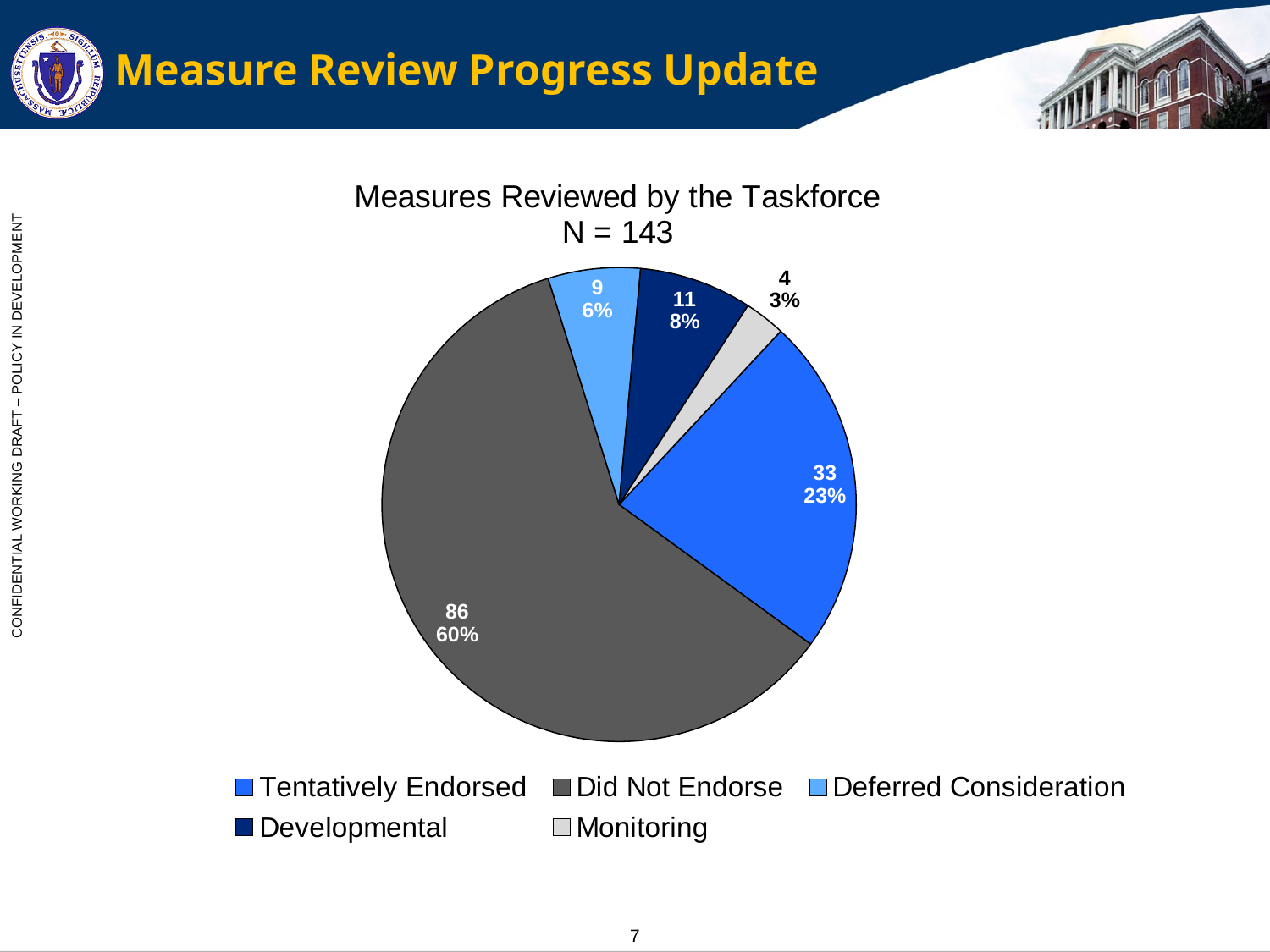
How many more measures were Did Not Endorse than Tentatively Endorsed? 53 Which category has the smallest slice of the pie? Monitoring What type of chart is shown on the slide? Pie chart How many categories does the legend list? 5 How many measures were in the Did Not Endorse category? 86 How many measures fall under Developmental? 11 What is the total number of measures (N) stated in the chart title? 143 Which has more measures, Developmental or Deferred Consideration? Developmental How many measures are in the Monitoring category? 4 What share of the pie does Deferred Consideration represent? 6% What percentage of measures were Tentatively Endorsed? 23% Which category has the largest slice of the pie? Did Not Endorse